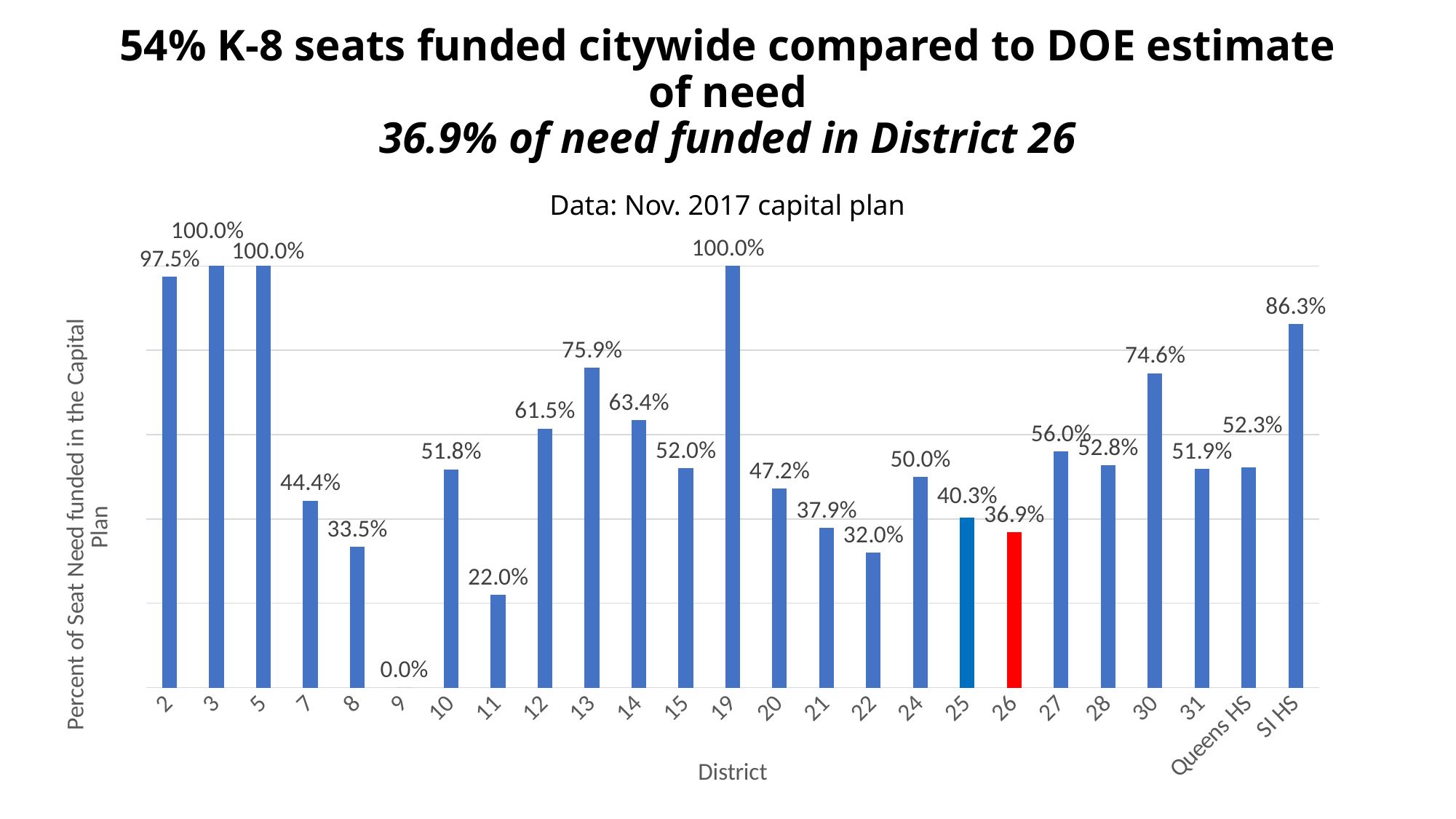
What is the value for District 13? 75.9% How many categories are shown on the x axis? 25 Which is larger, the value for District 12 or District 14? District 14 What kind of chart is shown on the slide? Bar chart What is the value for SI HS? 86.3% Which district has the lowest percent of seat need funded? 9 Which is larger, the value for District 30 or District 13? District 13 What is the difference between the values for District 13 and District 26? 39.0 percentage points What is the value for District 11? 22.0% What is the value for District 26? 36.9% What is the difference between the values for SI HS and Queens HS? 34.0 percentage points Which district's bar is coloured red? 26